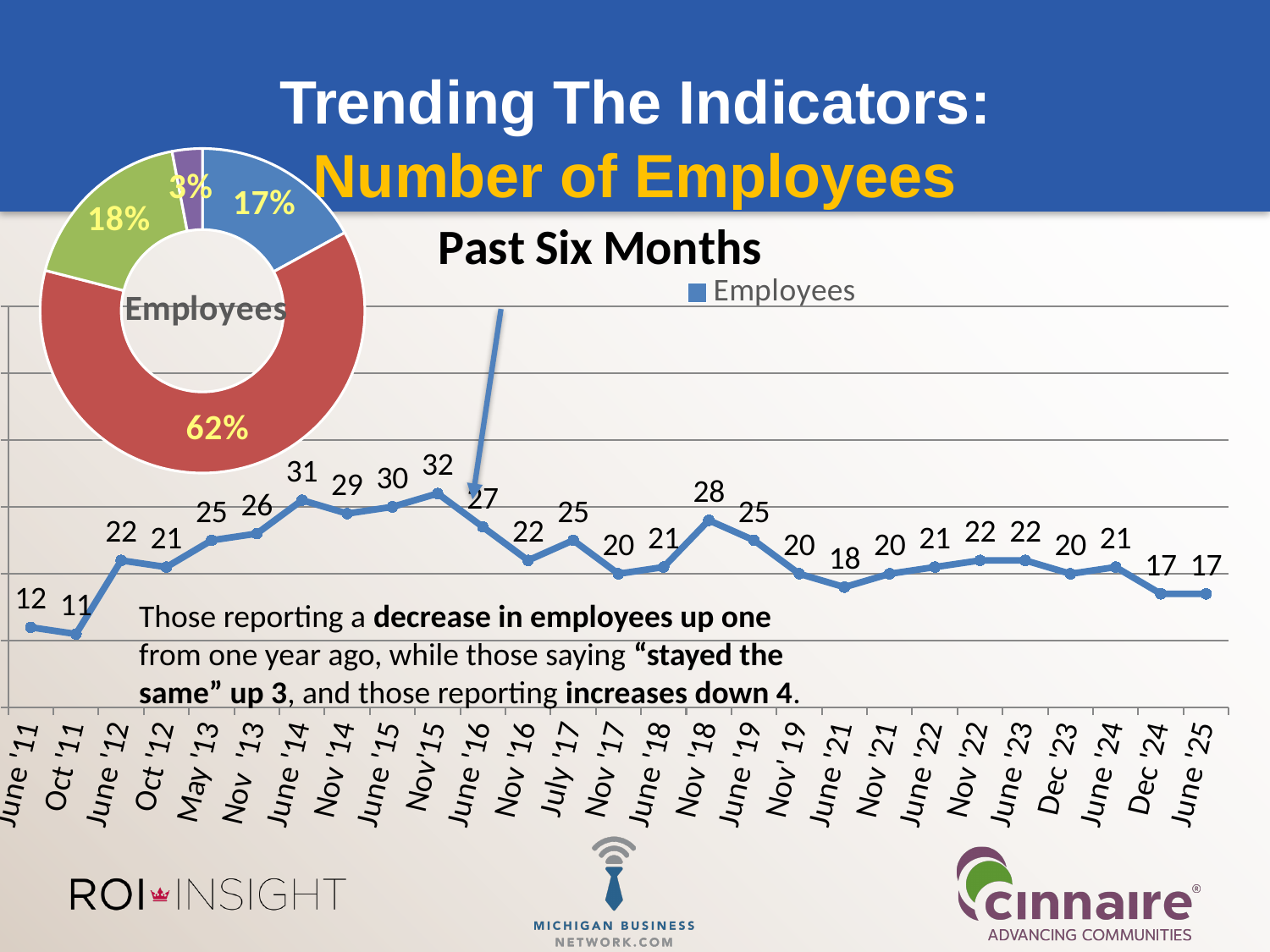
What kind of chart is the chart labelled "Employees" in the top left of the slide? doughnut (pie) chart On the line chart titled "Past Six Months", what is the value for June '25? 17 On the line chart titled "Past Six Months", how many data points are plotted? 27 On the line chart titled "Past Six Months", how many series does the legend list? 1 On the doughnut chart labelled "Employees", what is the share of the largest slice? 62% On the line chart titled "Past Six Months", which period has the lowest value? Oct '11 On the line chart titled "Past Six Months", what is the value for Nov '15? 32 On the line chart titled "Past Six Months", which period has the highest value? Nov '15 On the line chart titled "Past Six Months", do the values rise or fall from June '23 to June '25? fall On the line chart titled "Past Six Months", which is larger, the value for June '14 or the value for June '19? June '14 On the line chart titled "Past Six Months", what is the value for Nov '18? 28 On the line chart titled "Past Six Months", what is the difference between the values for June '24 and Dec '24? 4